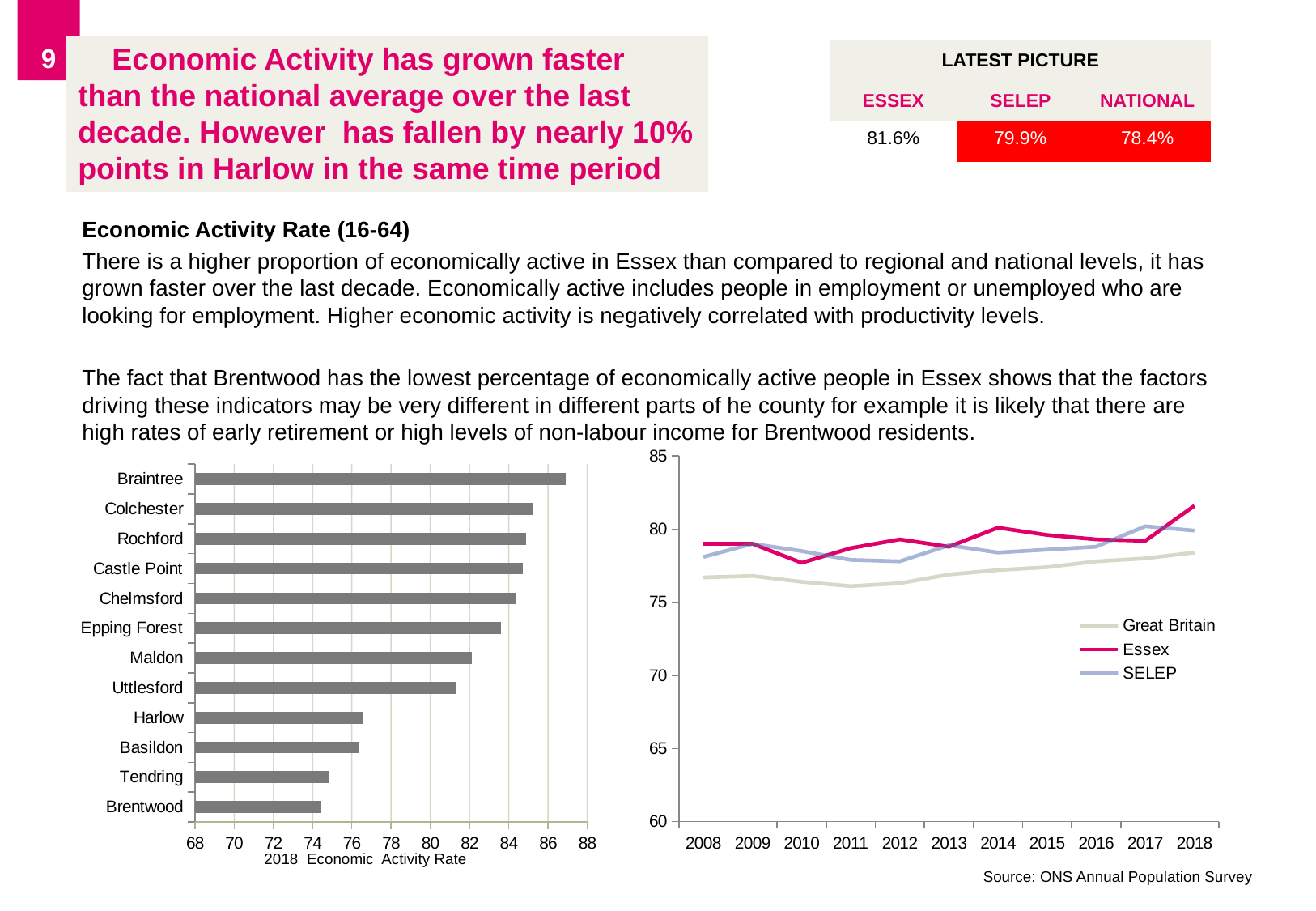
In the left bar chart of 2018 Economic Activity Rate, which district has the highest value? Braintree In the left bar chart of 2018 Economic Activity Rate, how many districts are shown? 12 In the left bar chart of 2018 Economic Activity Rate, which is larger, the value for Braintree or the value for Harlow? Braintree In the right line chart, how many series does the legend list? 3 In the left bar chart of 2018 Economic Activity Rate, is the value for Brentwood greater or less than 76? less What kind of chart is the left chart showing the 2018 Economic Activity Rate by district? Bar chart In the right line chart, is the value for Essex in 2018 greater or less than 80? greater In the left bar chart of 2018 Economic Activity Rate, which district has the lowest value? Brentwood In the right line chart, how many years are shown on the x axis? 11 What kind of chart is the right chart showing Great Britain, Essex and SELEP from 2008 to 2018? Line chart In the left bar chart of 2018 Economic Activity Rate, is the value for Braintree greater or less than 86? greater In the right line chart, does the Great Britain series generally rise or fall from 2008 to 2018? Rise